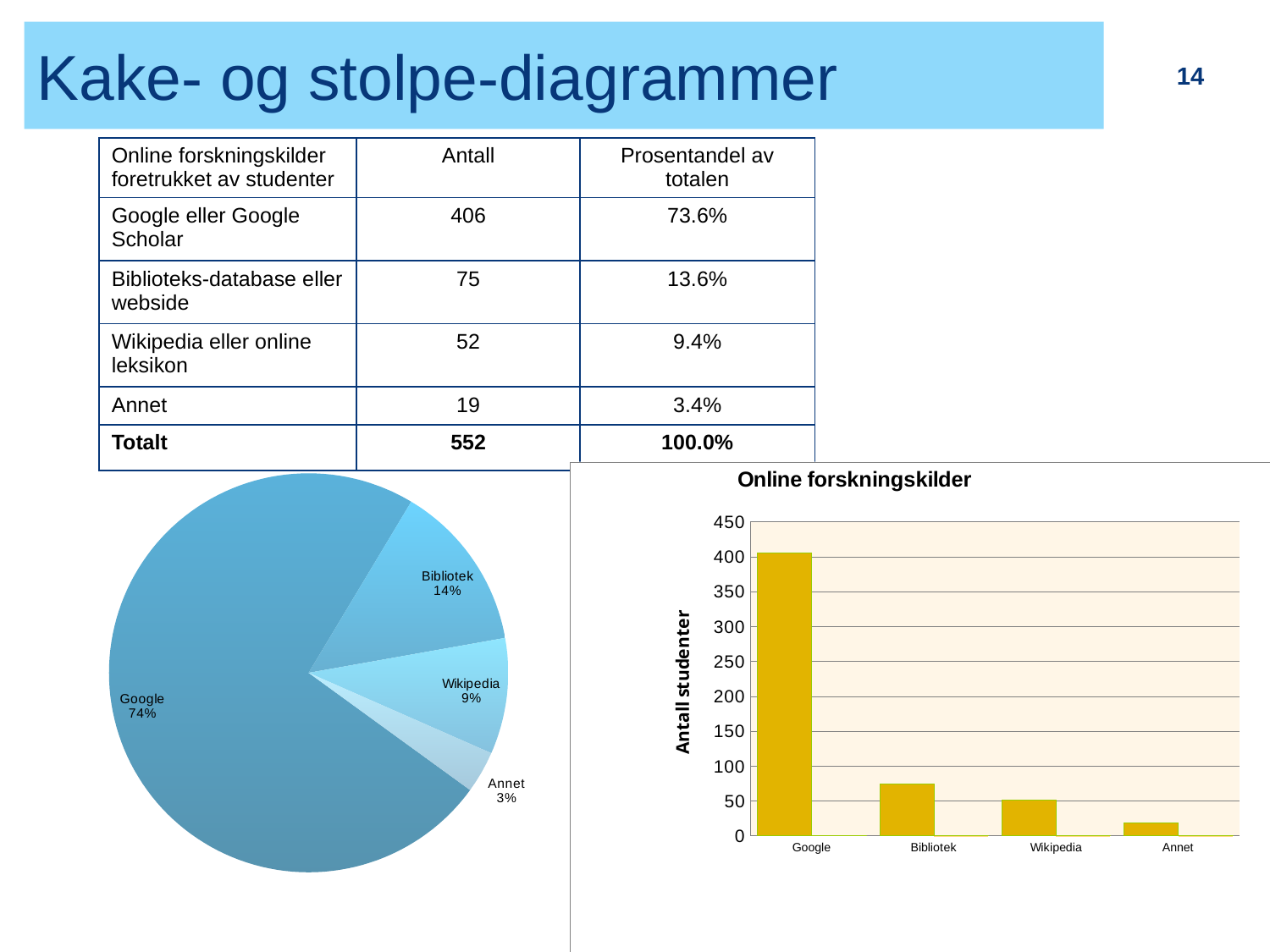
In the pie chart on the left, what share of the pie does Annet have? 3% In the bar chart titled "Online forskningskilder", is the value for Bibliotek greater or less than 100? less In the bar chart titled "Online forskningskilder", is the value for Google greater or less than 400? greater What is the label on the vertical axis of the bar chart titled "Online forskningskilder"? Antall studenter In the bar chart titled "Online forskningskilder", which category has the lowest bar? Annet In the pie chart on the left, which slice is the largest? Google What kind of chart is the chart titled "Online forskningskilder"? bar chart In the bar chart titled "Online forskningskilder", which is larger, the bar for Bibliotek or the bar for Wikipedia? Bibliotek In the pie chart on the left, what share of the pie does Bibliotek have? 14% In the pie chart on the left, how many slices are there? 4 In the pie chart on the left, what share of the pie does Google have? 74% What kind of chart is the chart on the left of the slide? pie chart